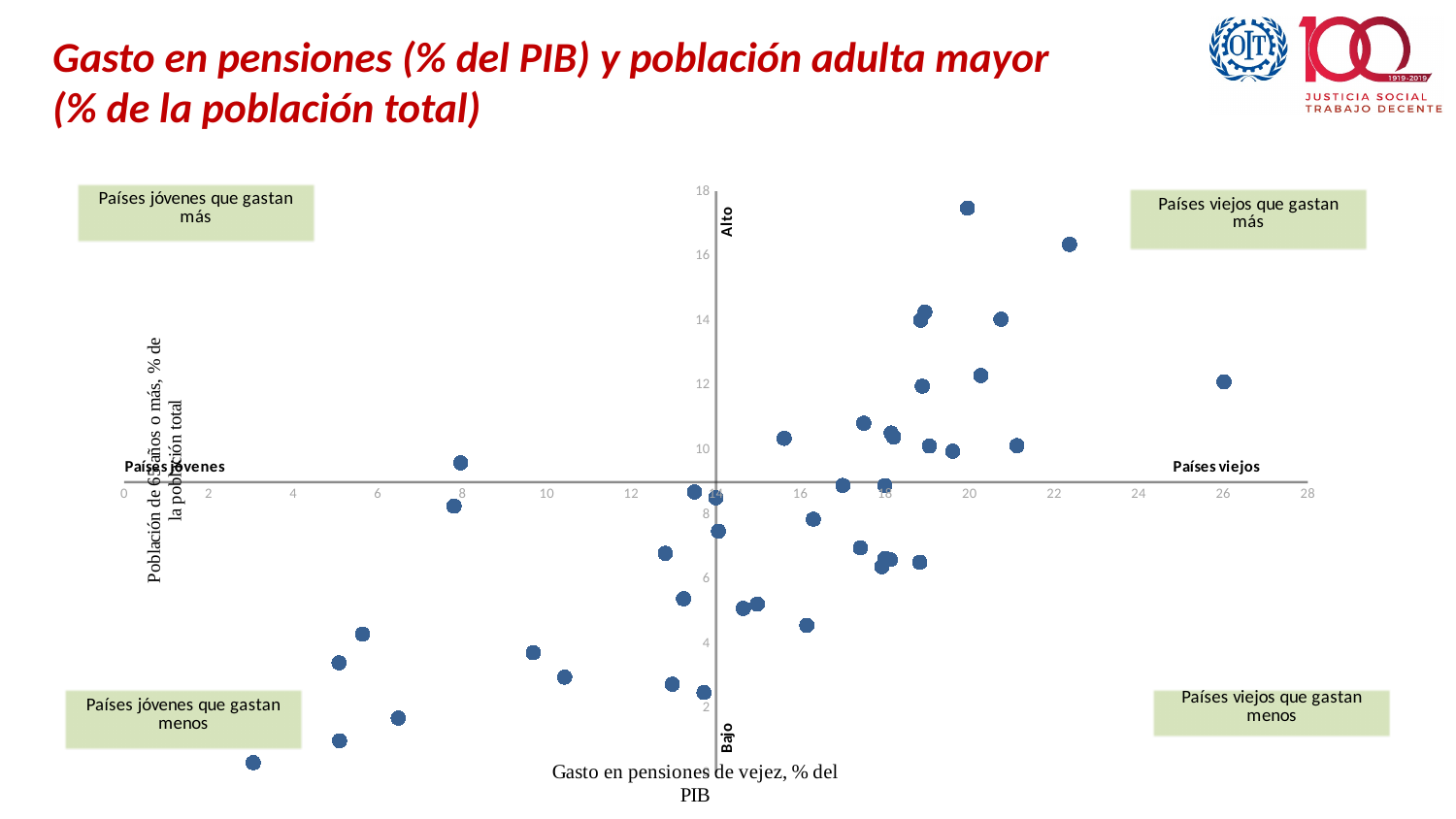
Is the horizontal-axis value of the rightmost point on the chart greater or less than 24? greater Is the vertical-axis value of the highest point on the chart greater or less than 16? greater Is the horizontal-axis value of the leftmost point on the chart greater or less than 4? less What label is shown in the box in the top-right quadrant of the chart? Países viejos que gastan más What is the title of the chart on the slide? Gasto en pensiones (% del PIB) y población adulta mayor (% de la población total) What kind of chart is shown on the slide? Scatter chart Do the points on the chart generally rise or fall as the horizontal-axis value increases? rise